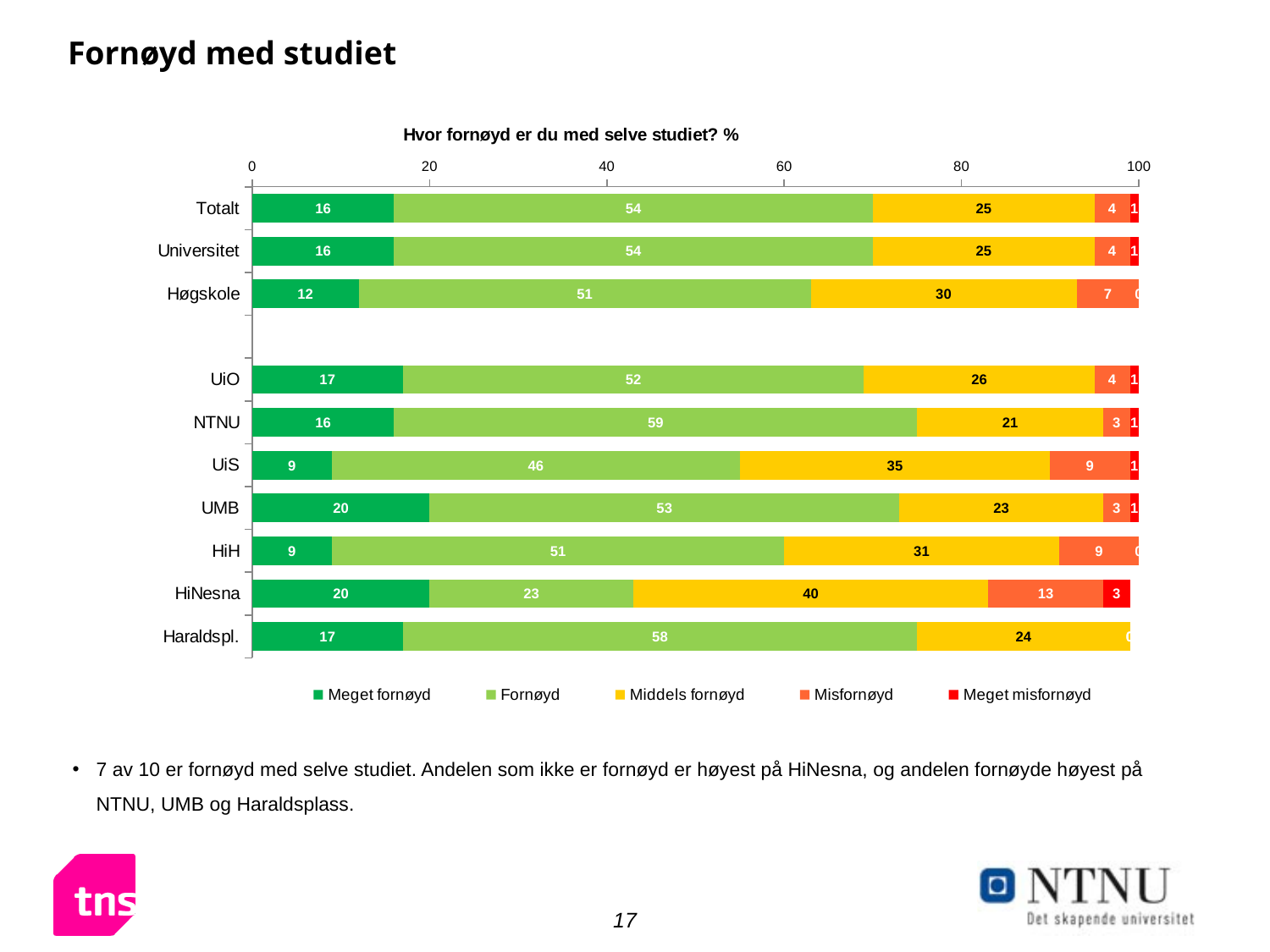
How many series does the legend list? 5 Which category has the highest Misfornøyd value? HiNesna What is the difference between the Middels fornøyd values for UiS and NTNU? 14 What is the Meget fornøyd value for UiS? 9 What is the Misfornøyd value for Høgskole? 7 What is the Middels fornøyd value for HiNesna? 40 What is the title of the chart? Hvor fornøyd er du med selve studiet? % What is the Fornøyd value for NTNU? 59 What kind of chart is shown on the slide? stacked bar chart Which category has the highest Fornøyd value? NTNU Which category has the lowest Fornøyd value? HiNesna Which is larger, the Meget fornøyd value for UMB or for UiO? UMB